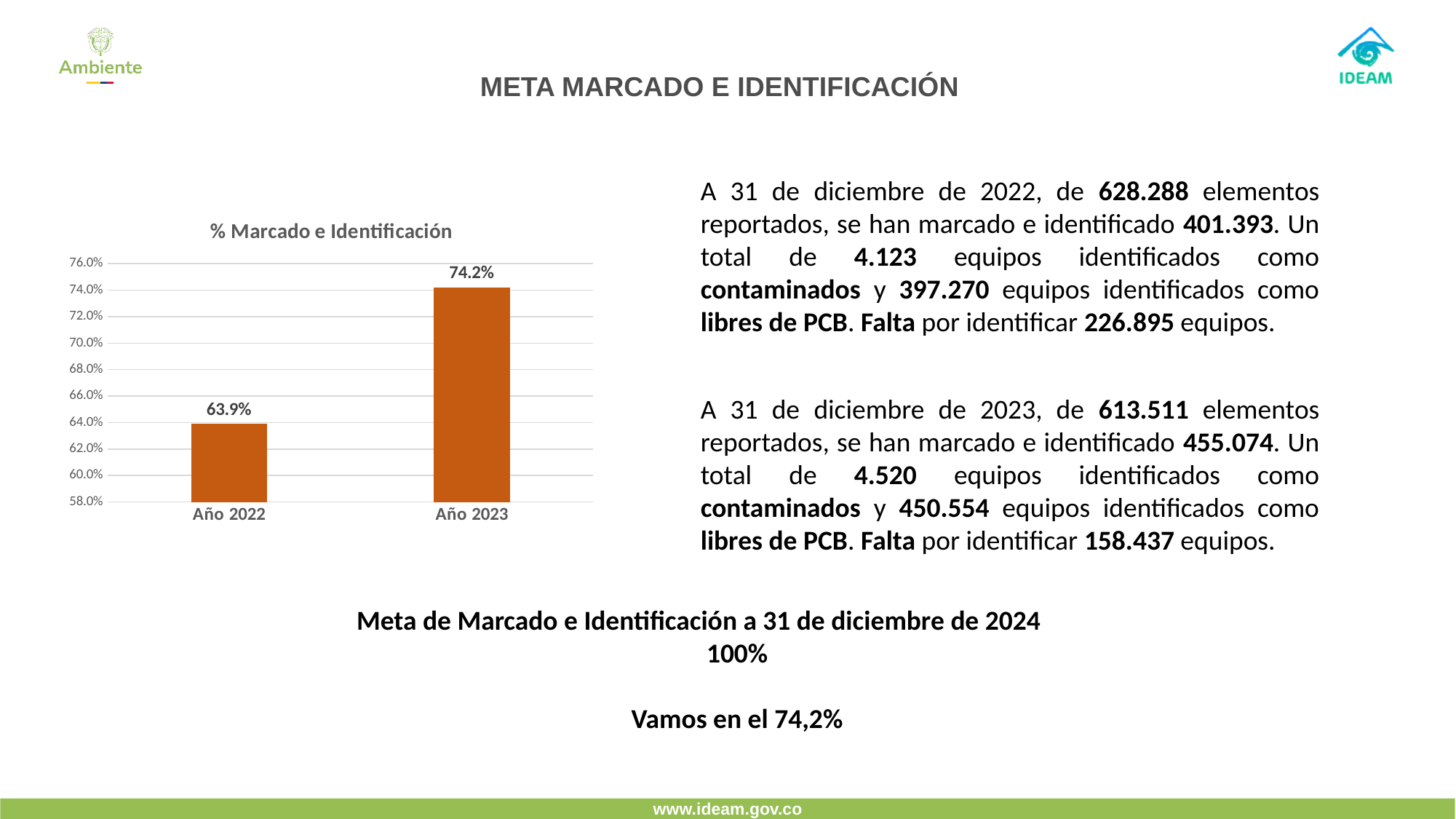
Is the value for Año 2022 greater or less than 66.0%? less What kind of chart is shown on the slide? bar chart Which year has the highest value in the chart? Año 2023 How many categories are shown in the chart? 2 Is the value for Año 2023 greater or less than 72.0%? greater What is the value for Año 2022 in the chart? 63.9% What is the title of the chart? % Marcado e Identificación Do the values rise or fall from Año 2022 to Año 2023? rise What is the value for Año 2023 in the chart? 74.2% Which is larger, the value for Año 2022 or Año 2023? Año 2023 Which year has the lowest value in the chart? Año 2022 What is the difference between the values for Año 2023 and Año 2022? 10.3%